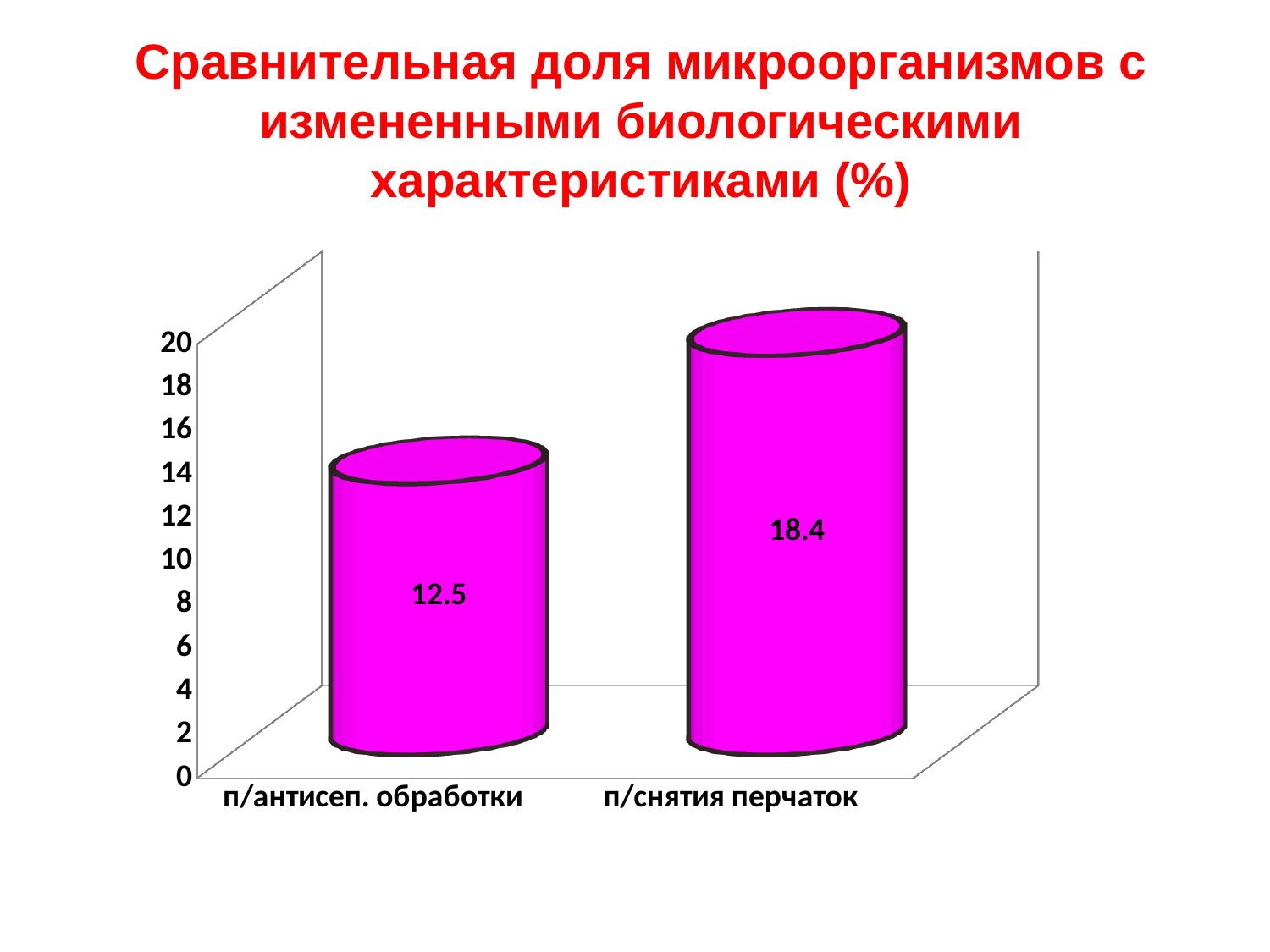
What colour are the bars in the chart? magenta Is the value for п/антисеп. обработки greater or less than 14? less What is the difference between the values for п/снятия перчаток and п/антисеп. обработки? 5.9 Which category has the lowest value? п/антисеп. обработки What is the value for п/антисеп. обработки? 12.5 What kind of chart is shown on the slide? bar chart Which is larger: the value for п/антисеп. обработки or the value for п/снятия перчаток? п/снятия перчаток What is the maximum value shown on the vertical axis? 20 How many categories are shown on the chart? 2 Is the value for п/снятия перчаток greater or less than 16? greater Which category has the highest value? п/снятия перчаток What is the value for п/снятия перчаток? 18.4